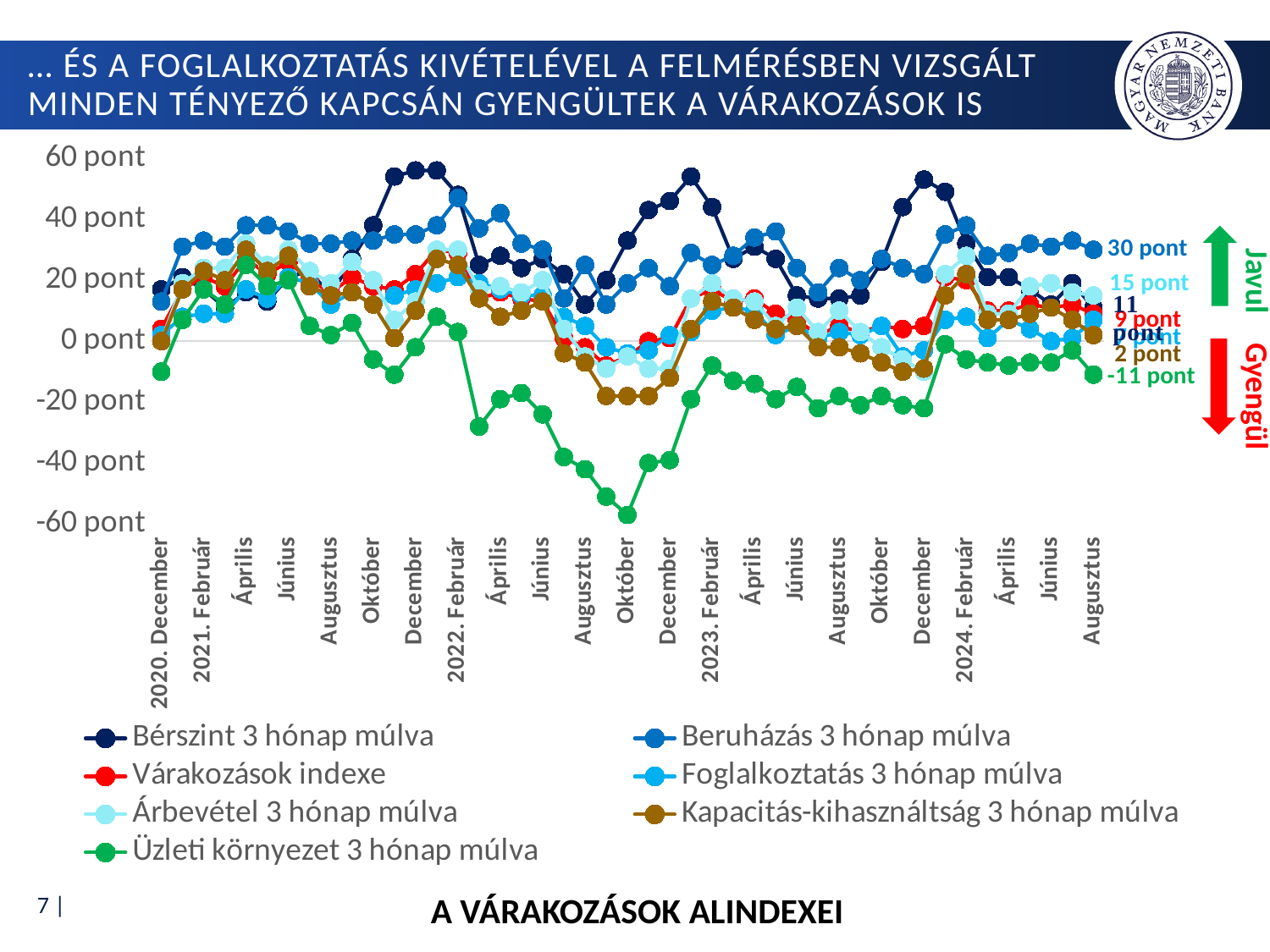
What is the title shown beneath the chart? A VÁRAKOZÁSOK ALINDEXEI What kind of chart is shown on the slide? line chart Which series has the lowest value at the end of the chart (2024 Augusztus)? Üzleti környezet 3 hónap múlva How many series does the legend list? 7 What is the latest (2024 Augusztus) value labelled for Beruházás 3 hónap múlva? 30 pont What is the latest value labelled for Várakozások indexe? 9 pont Which series has the highest value at the end of the chart (2024 Augusztus)? Beruházás 3 hónap múlva What is the latest value labelled for Kapacitás-kihasználtság 3 hónap múlva? 2 pont What is the latest value labelled for Üzleti környezet 3 hónap múlva? -11 pont What is the latest value labelled for Árbevétel 3 hónap múlva? 15 pont What is the difference between the latest labelled values of Beruházás 3 hónap múlva and Üzleti környezet 3 hónap múlva? 41 pont Is the value of Üzleti környezet 3 hónap múlva in 2022 Október greater or less than -40 pont? less